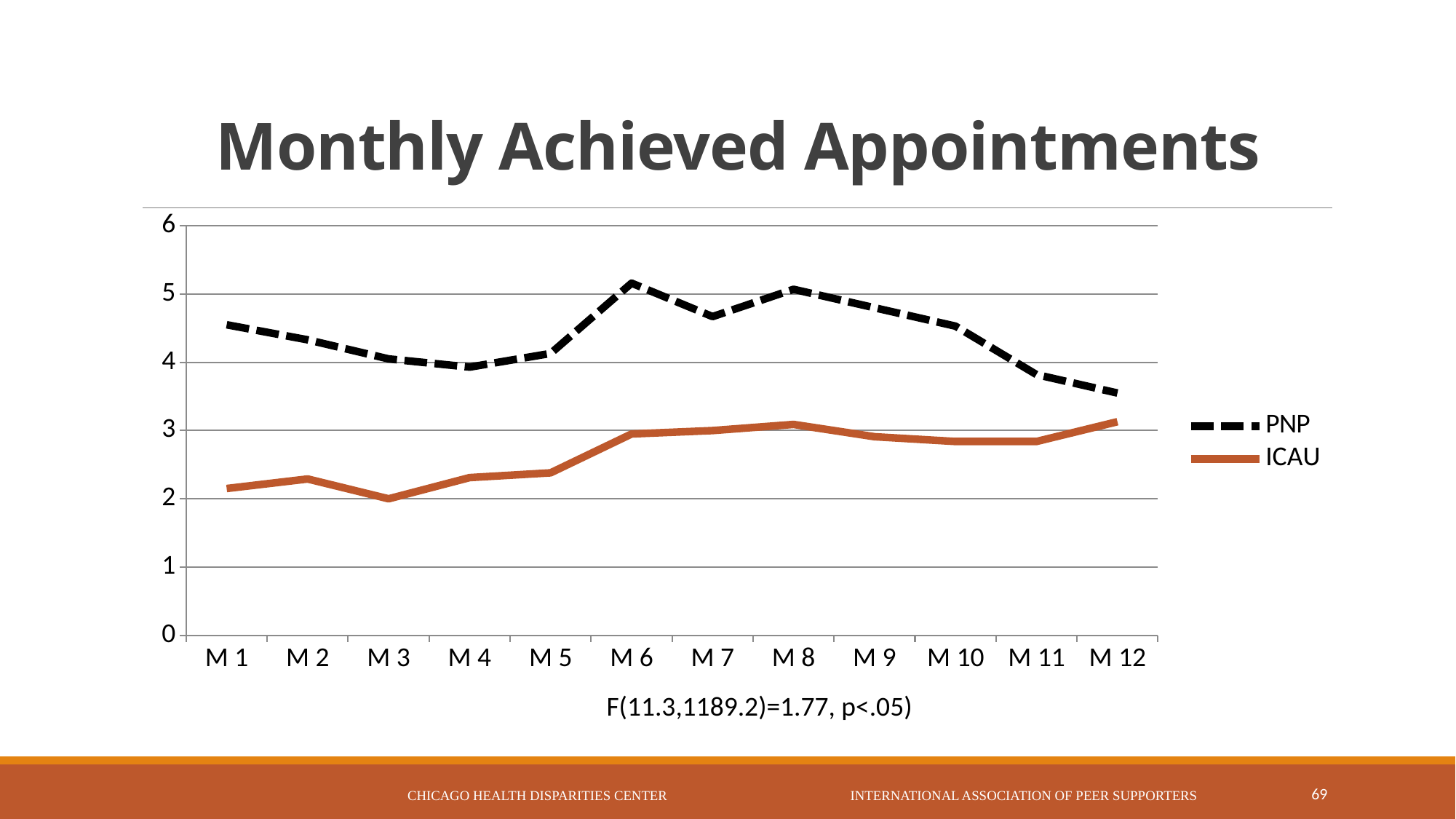
Is the value for ICAU at M 3 greater or less than 3? less In which month is the ICAU series at its lowest? M 3 Is the value for PNP at M 12 greater or less than 4? less In which month is the PNP series at its lowest? M 12 How many months are plotted along the x axis? 12 What kind of chart is shown on the slide? line chart Which series has the higher value at M 1, PNP or ICAU? PNP How many series does the legend list? 2 Is the value for ICAU at M 5 greater or less than 3? less What is the title of the chart? Monthly Achieved Appointments Does the PNP series rise or fall from M 8 to M 12? fall